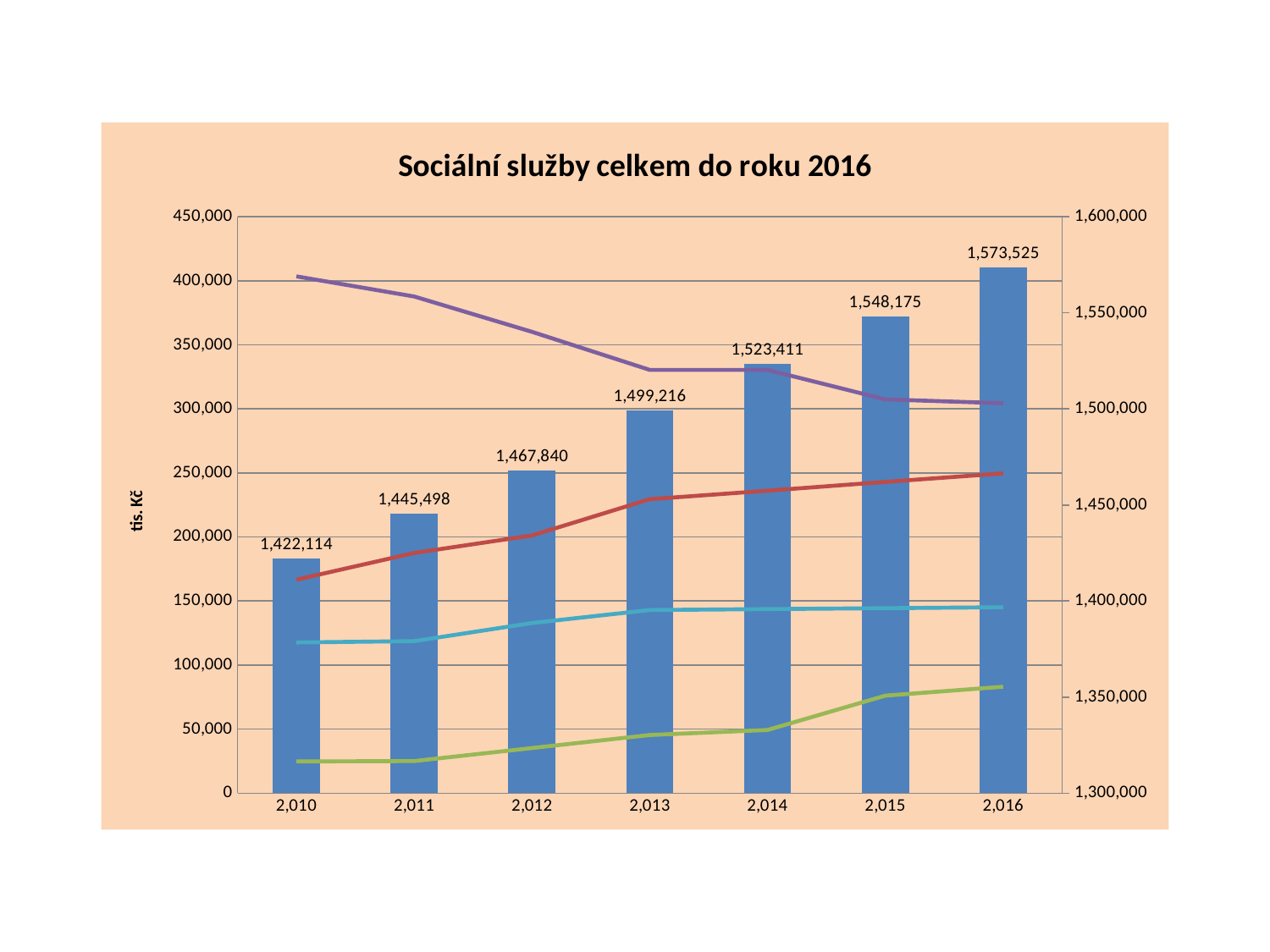
How many years are shown on the x axis? 7 What is the difference between the bar values for 2,015 and 2,014? 24,764 What is the value of the bar for 2,013? 1,499,216 Which year has the lowest bar value? 2,010 Which year has the highest bar value? 2,016 Does the purple line rise or fall from 2,010 to 2,016? fall Which bar is larger, 2,012 or 2,014? 2,014 What is the difference between the bar values for 2,016 and 2,010? 151,411 Do the bar values rise or fall from 2,010 to 2,016? rise What is the value of the bar for 2,010? 1,422,114 What is the value of the bar for 2,016? 1,573,525 What is the title of the chart? Sociální služby celkem do roku 2016